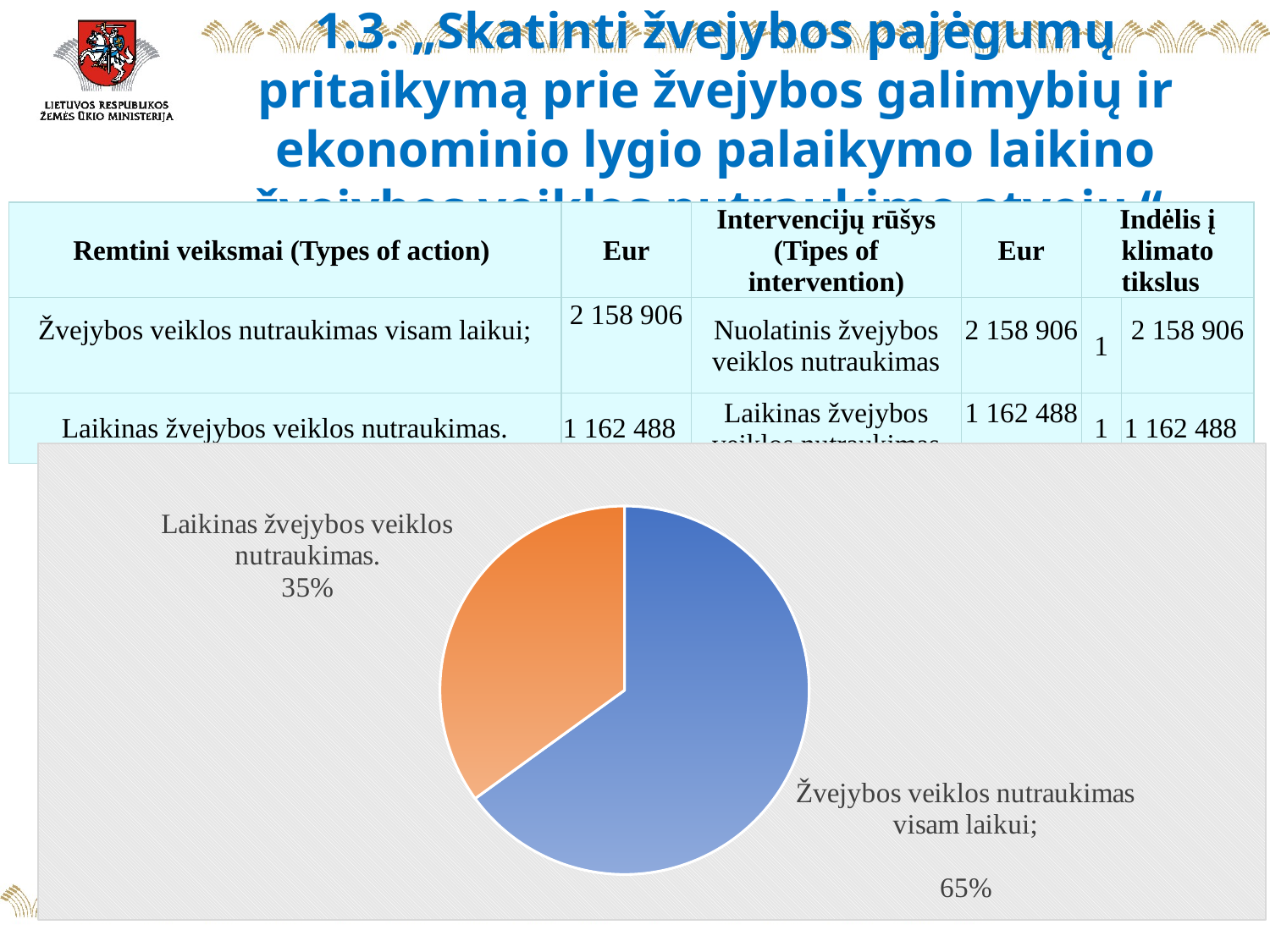
What share of the pie does "Žvejybos veiklos nutraukimas visam laikui;" represent? 65% Is the share for "Laikinas žvejybos veiklos nutraukimas." greater or less than 50%? less What kind of chart is shown on the slide? pie chart What is the total of the two percentage shares shown in the pie chart? 100% What share of the pie does "Laikinas žvejybos veiklos nutraukimas." represent? 35% What colour is the "Žvejybos veiklos nutraukimas visam laikui;" slice in the pie chart? blue Which slice of the pie chart is the smallest? Laikinas žvejybos veiklos nutraukimas. How many slices does the pie chart have? 2 What colour is the "Laikinas žvejybos veiklos nutraukimas." slice in the pie chart? orange Which is larger in the pie chart: "Laikinas žvejybos veiklos nutraukimas." or "Žvejybos veiklos nutraukimas visam laikui;"? Žvejybos veiklos nutraukimas visam laikui; Which slice of the pie chart is the largest? Žvejybos veiklos nutraukimas visam laikui; What is the difference in percentage points between the "Žvejybos veiklos nutraukimas visam laikui;" slice and the "Laikinas žvejybos veiklos nutraukimas." slice? 30 percentage points